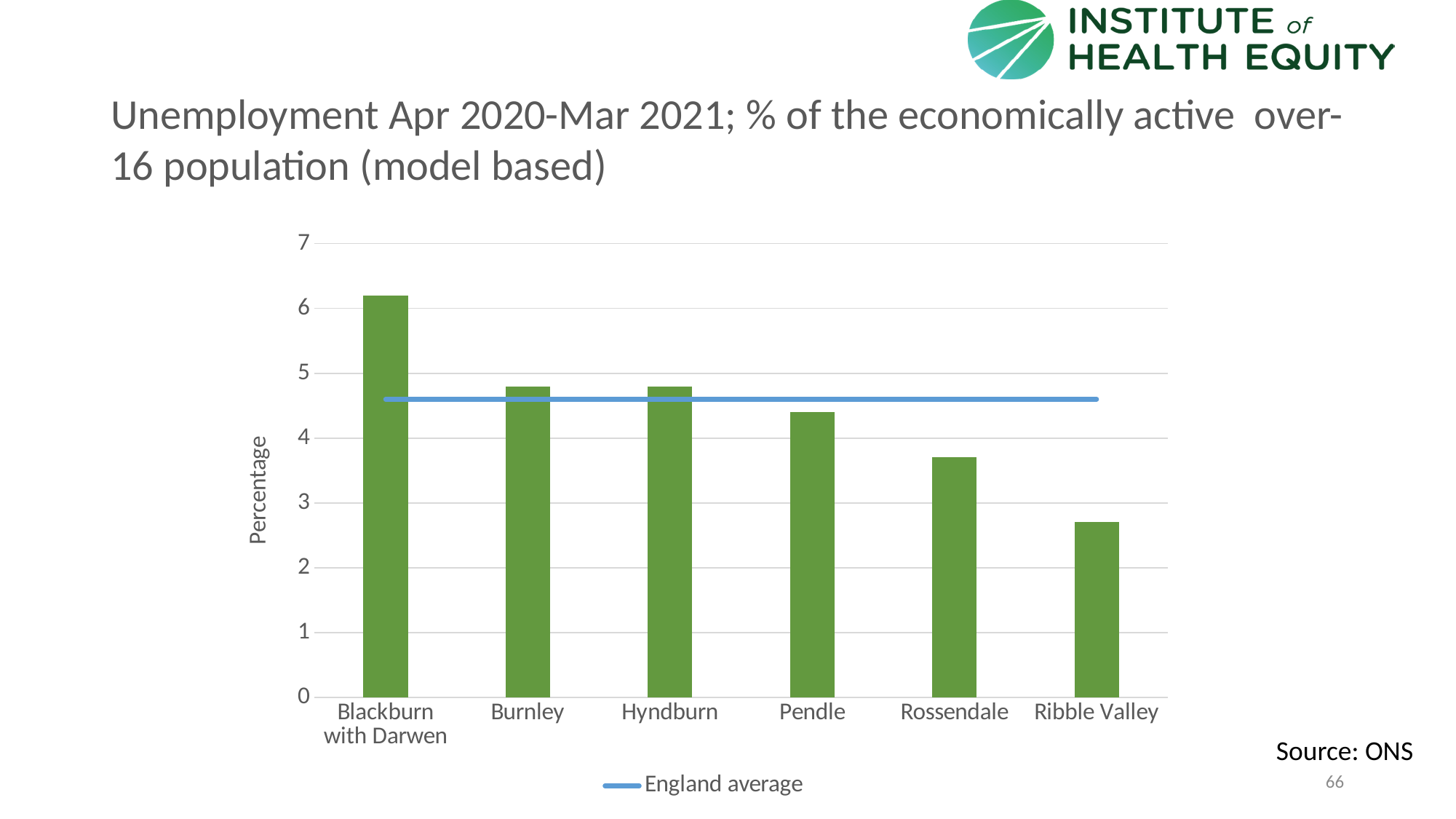
Which area has the highest unemployment rate in the chart? Blackburn with Darwen Which has the higher unemployment rate, Blackburn with Darwen or Pendle? Blackburn with Darwen Is the value for Ribble Valley greater or less than 3? less What does the horizontal blue line in the chart represent, according to the legend? England average Is the value for Blackburn with Darwen greater or less than 5? greater What kind of chart is shown on the slide? Bar chart Do the bar values rise or fall moving from left to right along the x axis? Fall Is the value for Rossendale greater or less than 4? less How many local authority areas are shown on the x axis of the chart? 6 Which has the lower unemployment rate, Rossendale or Ribble Valley? Ribble Valley Which area has the lowest unemployment rate in the chart? Ribble Valley